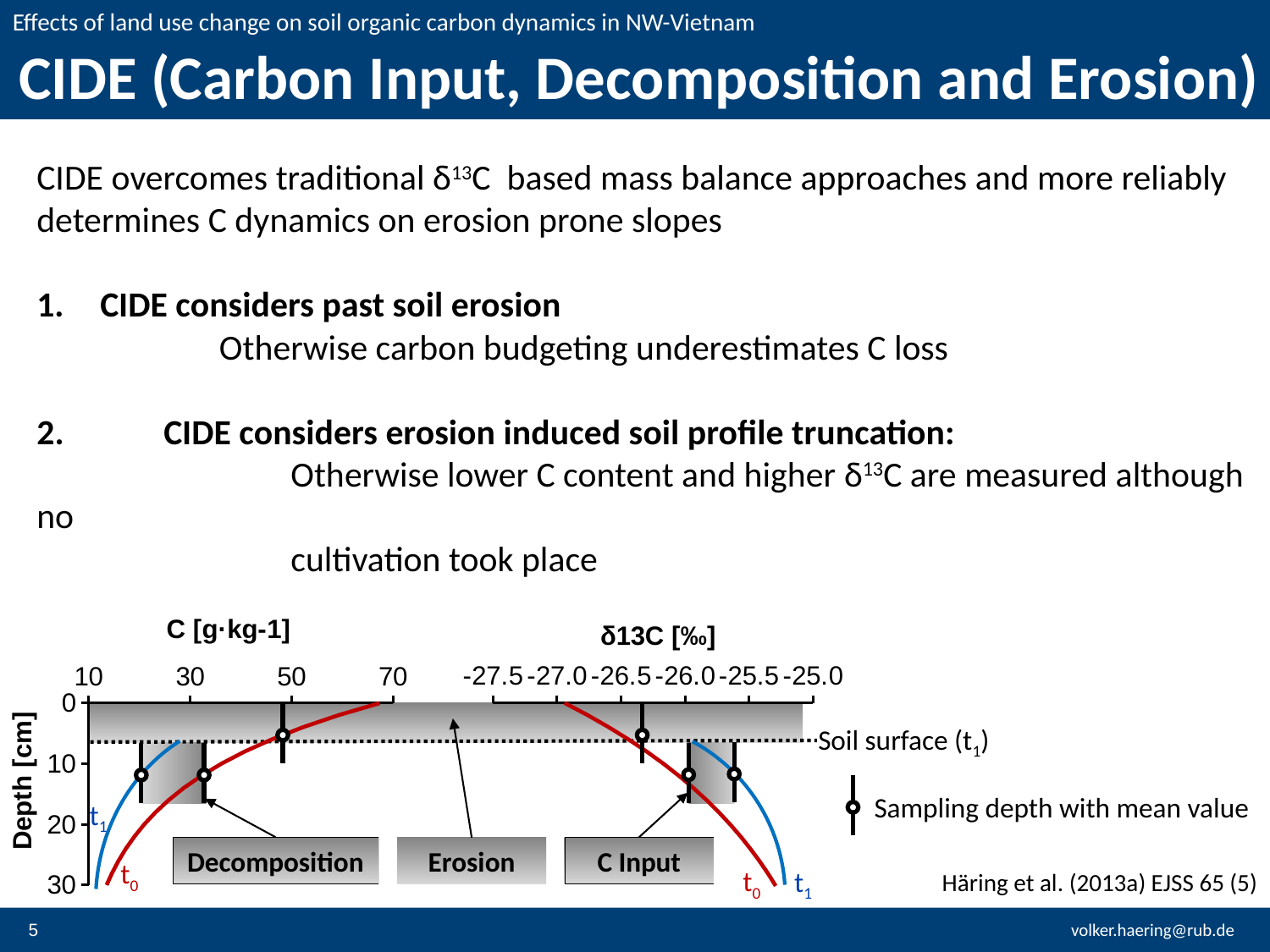
In the right panel (δ13C [‰]), do the δ13C values become more negative or less negative as depth increases? less negative What is the y-axis label shared by both panels of the diagram? Depth [cm] What is the x-axis label of the left panel of the diagram? C [g·kg-1] How many sampling-depth points (circles) are plotted in the right panel (δ13C [‰])? 3 What kind of chart is used in the diagram at the bottom of the slide? line chart In the left panel, is the value of the t0 curve at the soil surface (depth 0) greater or less than 50? greater How many time curves (t0, t1) are drawn in each panel of the diagram? 2 In the left panel, is the value of the t1 curve at 30 cm depth greater or less than 30? less In the left panel (C [g·kg-1]), does the carbon content rise or fall as depth increases? fall How many sampling-depth points (circles) are plotted in the left panel (C [g·kg-1])? 3